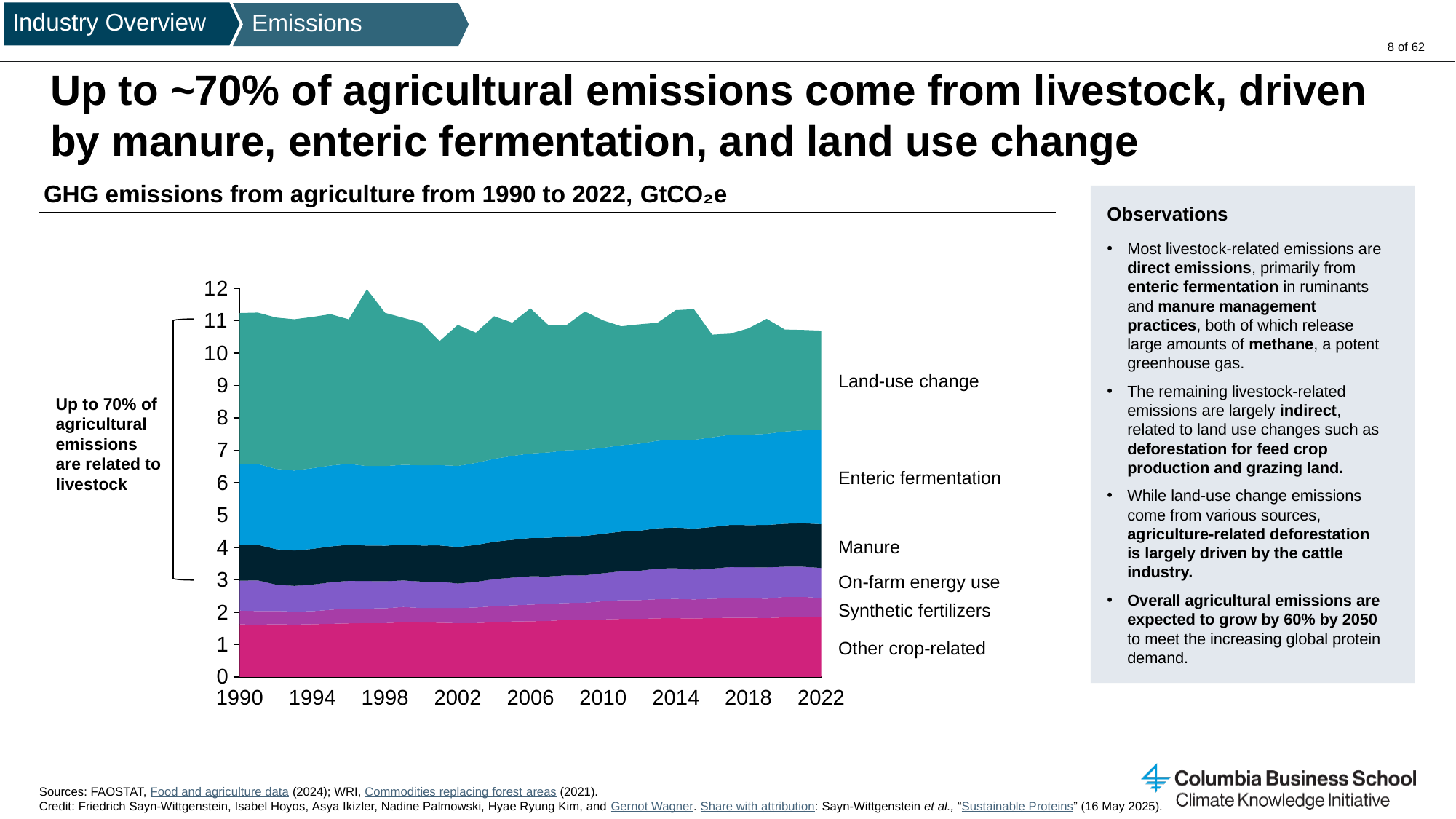
Is the cumulative top of the Enteric fermentation band in 2022 greater or less than 7? greater Which series forms the thinnest band in the chart? Synthetic fertilizers Is the total of all stacked series in 2022 greater or less than 10? greater Which three series are bracketed as the livestock-related emissions making up to 70% of agricultural emissions? Land-use change, Enteric fermentation, Manure Does the Enteric fermentation band get thicker or thinner from 1990 to 2022? thicker Is the cumulative top of the Enteric fermentation band in 1990 greater or less than 7? less How many year labels are shown on the x axis? 9 What is the title of the chart? GHG emissions from agriculture from 1990 to 2022, GtCO₂e How many emission categories (series) are stacked in the chart? 6 What kind of chart is shown on the slide? Stacked area chart Which series forms the largest band in 1990? Land-use change